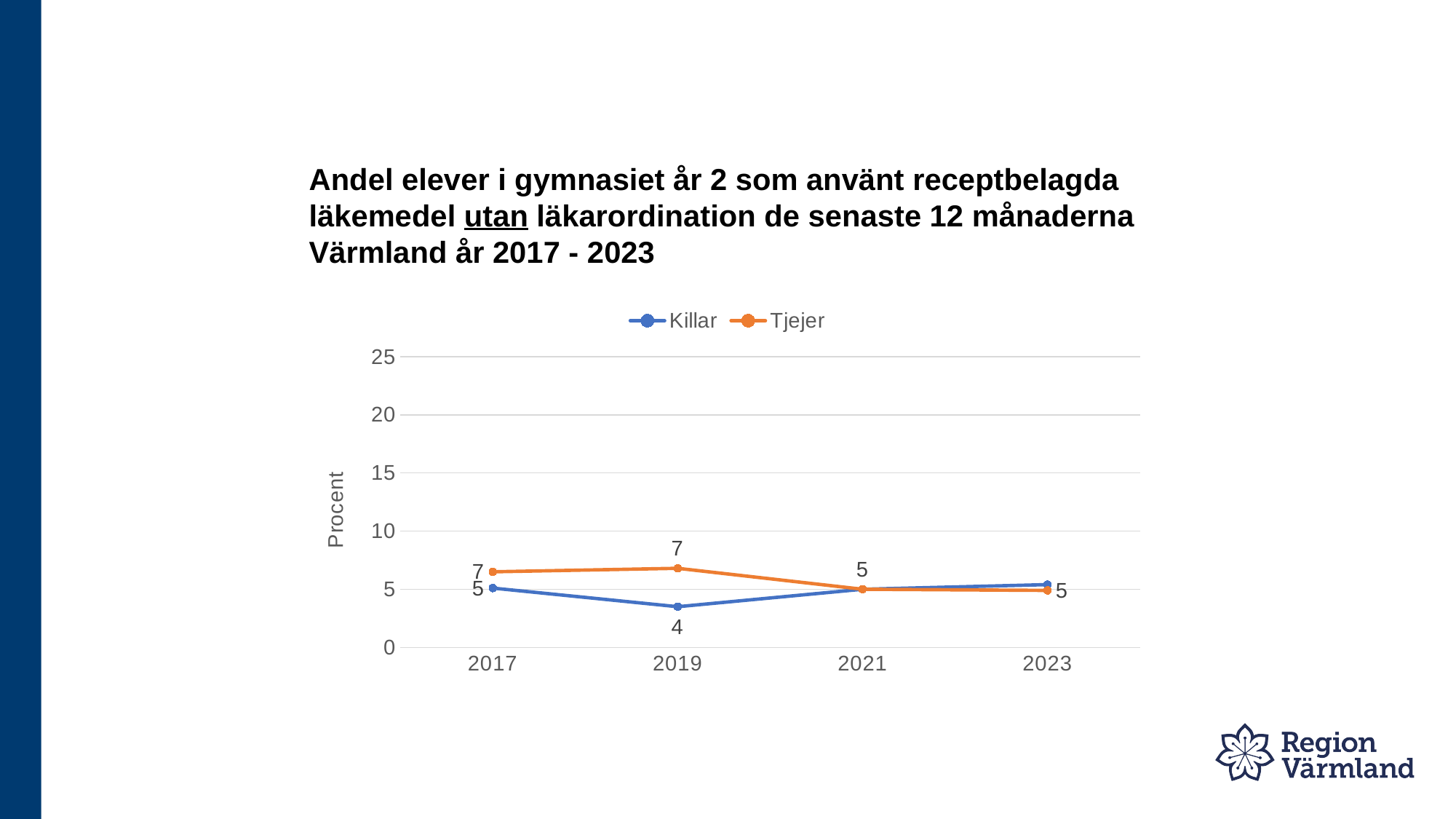
Which series are listed in the legend? Killar and Tjejer In which year is the Killar value lowest? 2019 Is the value for Tjejer in 2023 greater or less than 10? less What is the value for Tjejer in 2017? 7 What is the value for Killar in 2019? 4 What type of chart is shown on the slide? line chart How many series does the legend list? 2 In 2017, which series has the larger value, Killar or Tjejer? Tjejer What is the value for Killar in 2017? 5 How many years are shown on the x axis? 4 What is the value for Tjejer in 2019? 7 What is the difference between the Tjejer and Killar values in 2019? 3